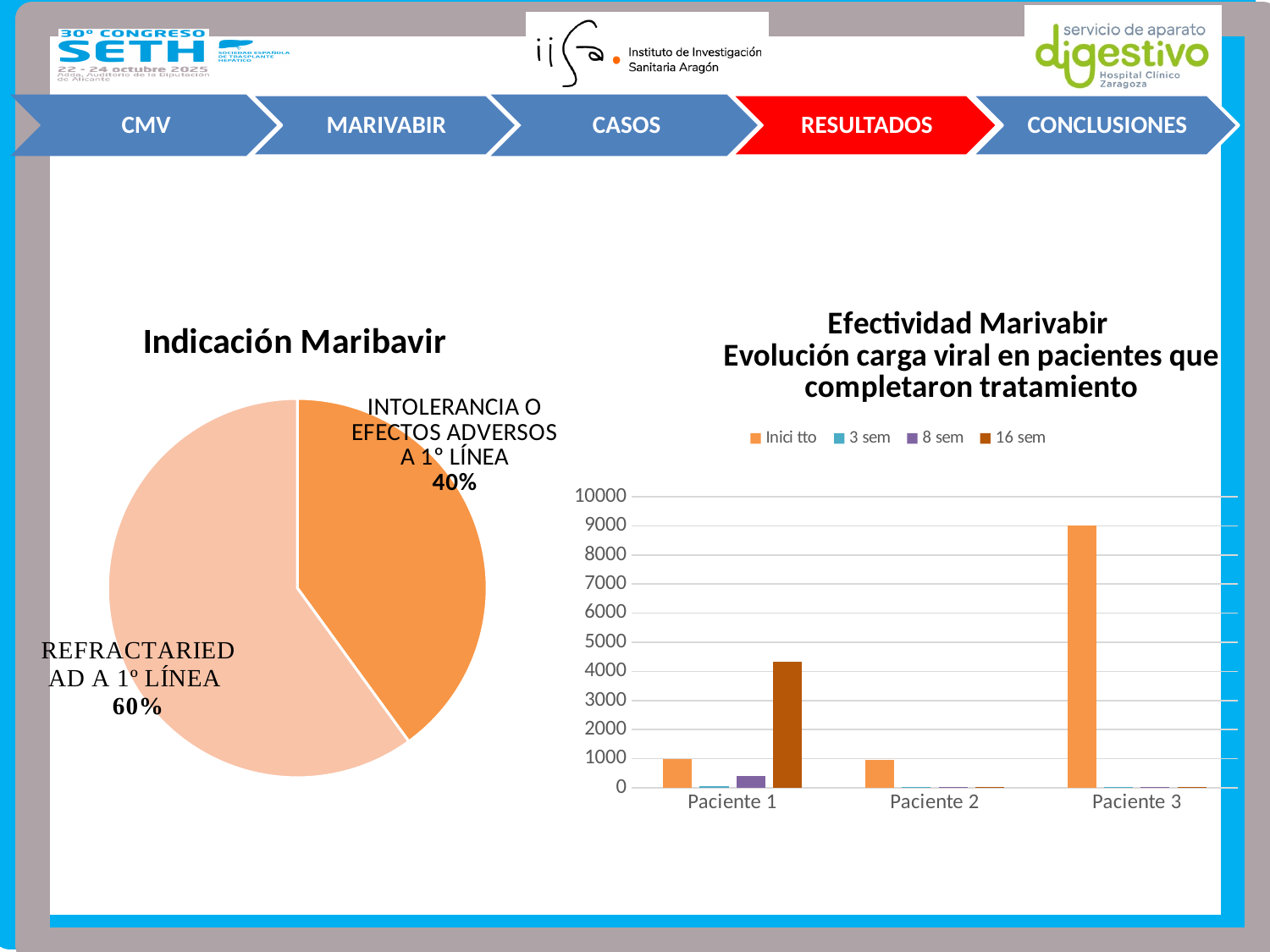
In the 'Efectividad Marivabir' chart, how many series does the legend list? 4 In the pie chart 'Indicación Maribavir', what is the difference in percentage points between the two slices? 20% In the 'Efectividad Marivabir' chart, how many patients are shown on the x axis? 3 What kind of chart is the 'Efectividad Marivabir' chart on the right of the slide? Bar chart In the 'Efectividad Marivabir' chart, is the Inici tto value for Paciente 3 greater or less than 8000? greater In the pie chart 'Indicación Maribavir', what share is labelled REFRACTARIEDAD A 1º LÍNEA? 60% In the pie chart 'Indicación Maribavir', what share is labelled INTOLERANCIA O EFECTOS ADVERSOS A 1º LÍNEA? 40% In the pie chart 'Indicación Maribavir', how many slices are there? 2 What kind of chart is the chart on the left of the slide? Pie chart In the 'Efectividad Marivabir' chart, is the 16 sem value for Paciente 1 greater or less than 4000? greater In the pie chart 'Indicación Maribavir', which slice is the largest? REFRACTARIEDAD A 1º LÍNEA In the 'Efectividad Marivabir' chart, which patient has the highest Inici tto value? Paciente 3